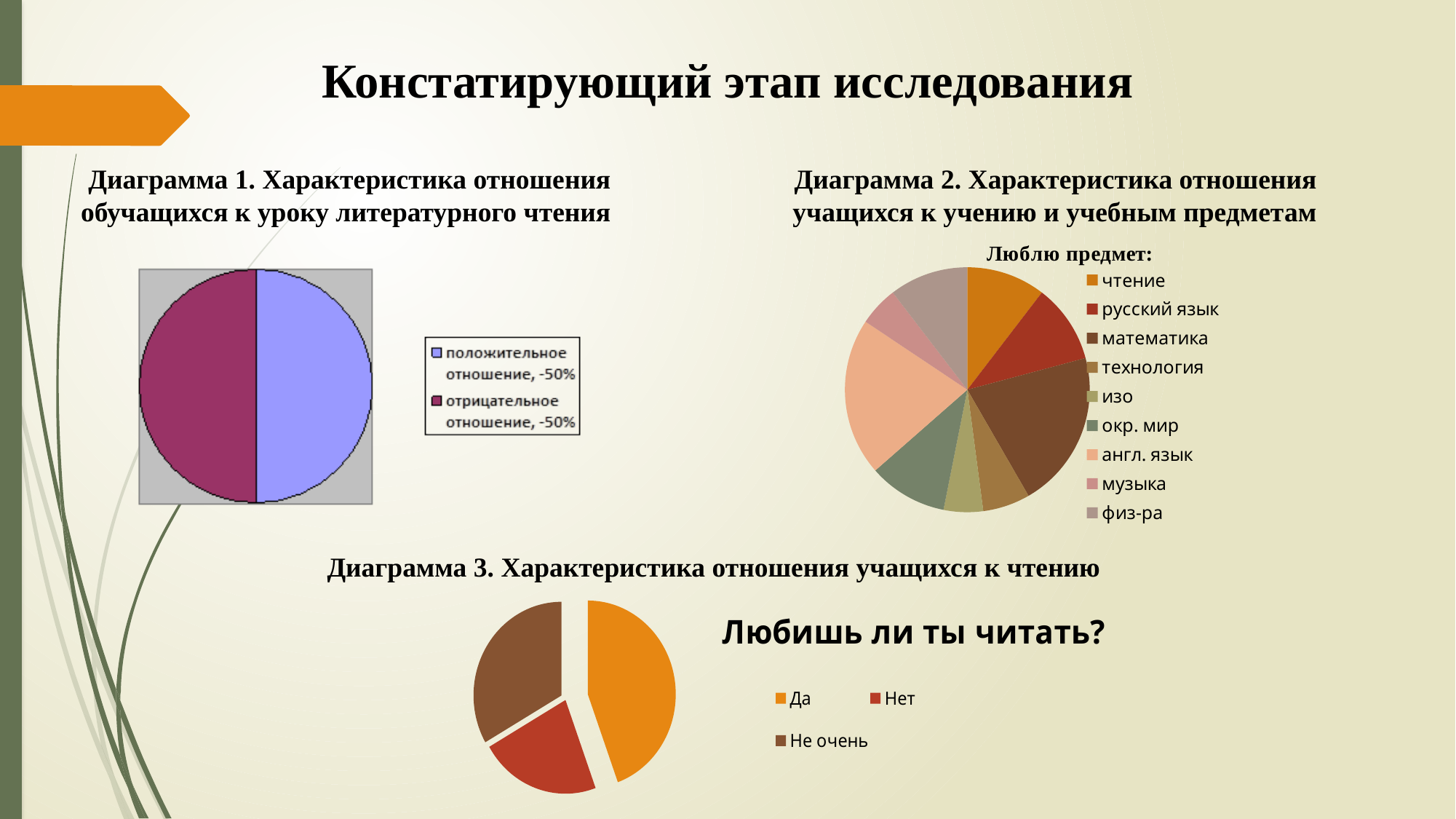
How many categories does the legend of Диаграмма 2 list? 9 In Диаграмма 3, which category has the largest slice? Да How many entries does the legend of Диаграмма 1 list? 2 What kind of chart is Диаграмма 3? pie chart In Диаграмма 3, which category has the smallest slice? Нет What kind of chart is Диаграмма 1? pie chart What is the title shown above the pie in Диаграмма 2? Люблю предмет: How many categories does the legend of Диаграмма 3 list? 3 In Диаграмма 2, which legend entry is listed first? чтение What kind of chart is Диаграмма 2? pie chart In Диаграмма 1, what value is shown for отрицательное отношение? -50% In Диаграмма 1, what value is shown for положительное отношение? -50%